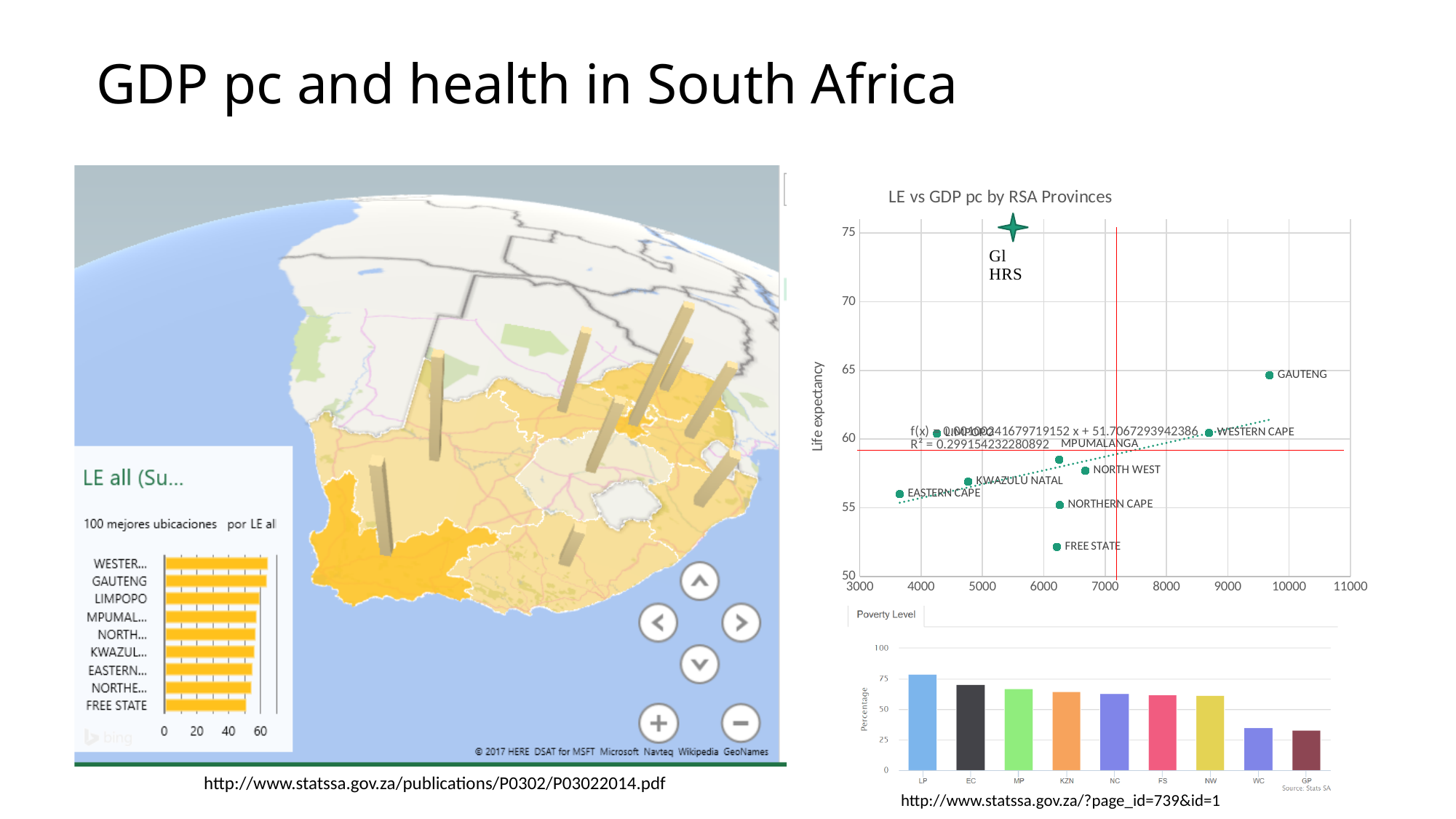
In the 'LE all' bar chart on the map, which province has the lowest value? FREE STATE In the 'Poverty Level' bar chart, is the value for WC greater or less than 50? less In the 'LE vs GDP pc by RSA Provinces' chart, which province has the highest life expectancy? GAUTENG In the 'Poverty Level' bar chart, which province has the highest percentage? LP In the 'LE vs GDP pc by RSA Provinces' chart, which has the higher life expectancy, GAUTENG or EASTERN CAPE? GAUTENG What kind of chart is the 'LE vs GDP pc by RSA Provinces' chart? scatter chart In the 'LE vs GDP pc by RSA Provinces' chart, does the dotted trend line rise or fall as GDP per capita increases? rises In the 'LE vs GDP pc by RSA Provinces' chart, how many provinces are plotted? 9 In the 'LE vs GDP pc by RSA Provinces' chart, is the life expectancy for GAUTENG greater or less than 60? greater In the 'LE vs GDP pc by RSA Provinces' chart, is the life expectancy for FREE STATE greater or less than 55? less In the 'LE vs GDP pc by RSA Provinces' chart, which province has the lowest life expectancy? FREE STATE In the 'Poverty Level' bar chart, how many provinces are shown? 9